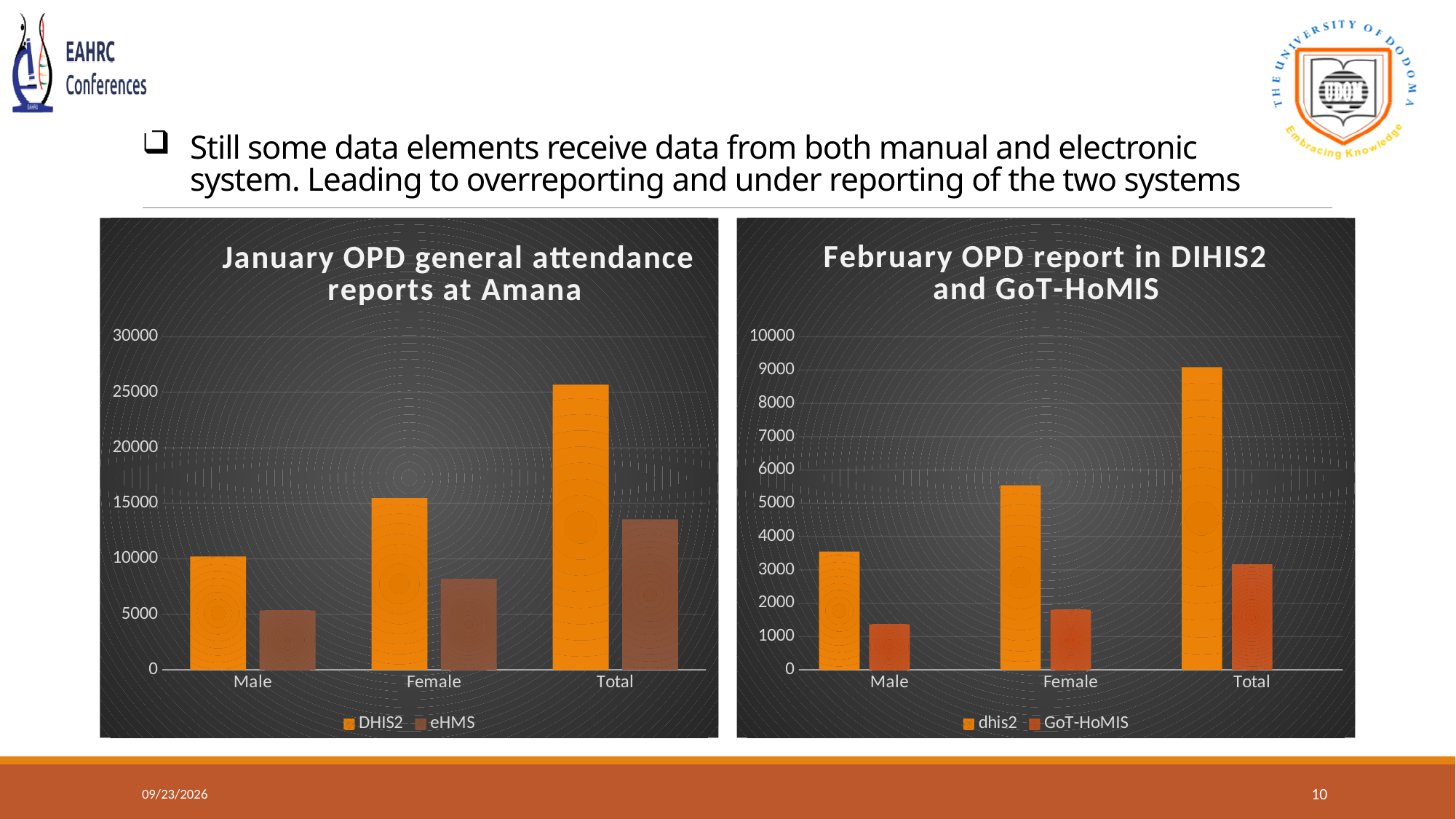
In the February OPD report in DIHIS2 and GoT-HoMIS chart, is the dhis2 value for Female greater or less than 5000? greater What are the two legend entries of the January OPD general attendance reports at Amana chart? DHIS2 and eHMS In the January OPD general attendance reports at Amana chart, which is larger for Female: DHIS2 or eHMS? DHIS2 In the February OPD report in DIHIS2 and GoT-HoMIS chart, is the dhis2 value for Total greater or less than 8000? greater In the January OPD general attendance reports at Amana chart, is the eHMS value for Female greater or less than 10000? less In the January OPD general attendance reports at Amana chart, which category has the highest DHIS2 value? Total What type of chart is the January OPD general attendance reports at Amana chart? bar chart In the February OPD report in DIHIS2 and GoT-HoMIS chart, which category has the lowest GoT-HoMIS value? Male How many categories are shown on the x axis of the January OPD general attendance reports at Amana chart? 3 How many series does the legend of the February OPD report in DIHIS2 and GoT-HoMIS chart list? 2